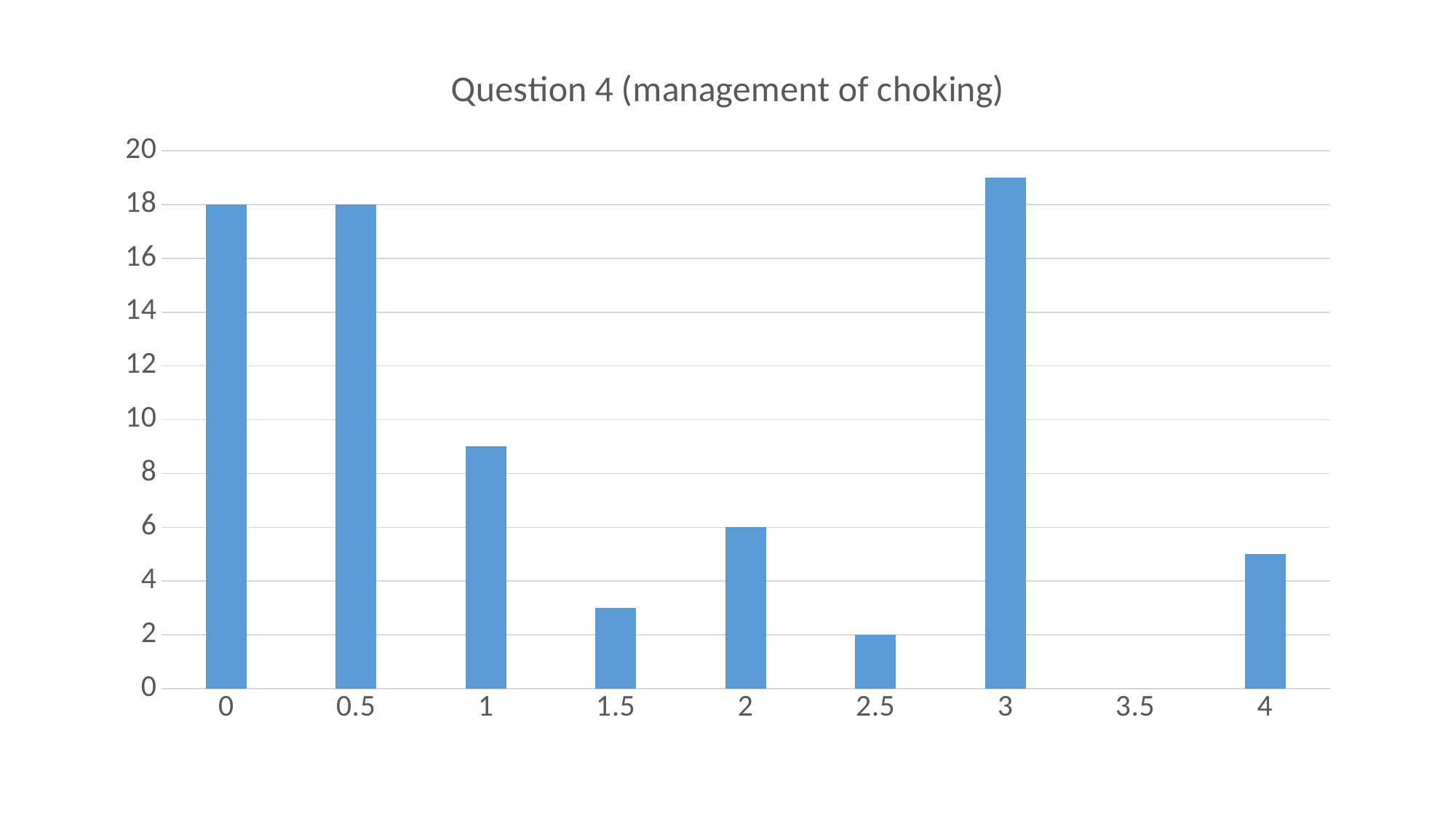
How many categories are shown on the x axis? 9 What is the title of the chart? Question 4 (management of choking) Is the value for category 1 greater or less than 8? greater Is the value for category 4 greater or less than 6? less Is the value for category 3 greater or less than 18? greater What is the difference between the values for categories 0 and 2? 12 Which category has the highest bar? 3 What is the value for category 0.5? 18 What kind of chart is shown on the slide? bar chart What is the value for category 2? 6 What is the value for category 2.5? 2 What is the value for category 0? 18